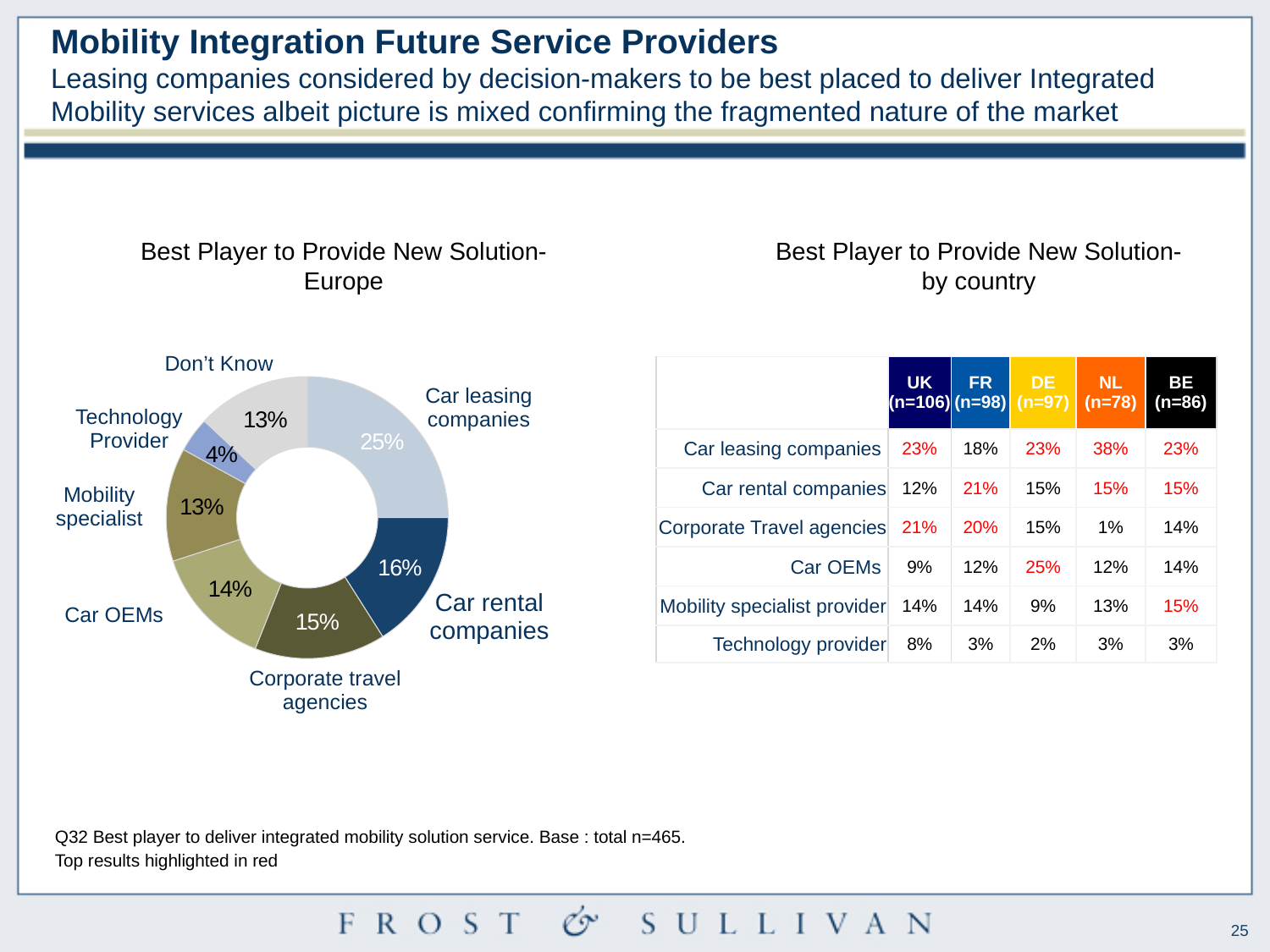
In the 'Best Player to Provide New Solution- Europe' chart, what share is shown for Don't Know? 13% In the 'Best Player to Provide New Solution- Europe' chart, which category has the largest slice? Car leasing companies In the 'Best Player to Provide New Solution- Europe' chart, what is the difference in percentage points between Car leasing companies and Car rental companies? 9 percentage points In the 'Best Player to Provide New Solution- Europe' chart, what share is shown for Car rental companies? 16% What is the title of the chart on the left side of the slide? Best Player to Provide New Solution- Europe In the 'Best Player to Provide New Solution- Europe' chart, what share is shown for Car leasing companies? 25% How many categories (slices) are shown in the 'Best Player to Provide New Solution- Europe' chart? 7 In the 'Best Player to Provide New Solution- Europe' chart, what share is shown for Corporate travel agencies? 15% In the 'Best Player to Provide New Solution- Europe' chart, which category has the smallest slice? Technology Provider In the 'Best Player to Provide New Solution- Europe' chart, what share is shown for Technology Provider? 4% What kind of chart is 'Best Player to Provide New Solution- Europe'? Pie chart (doughnut) In the 'Best Player to Provide New Solution- Europe' chart, which is larger: Car OEMs or Mobility specialist? Car OEMs